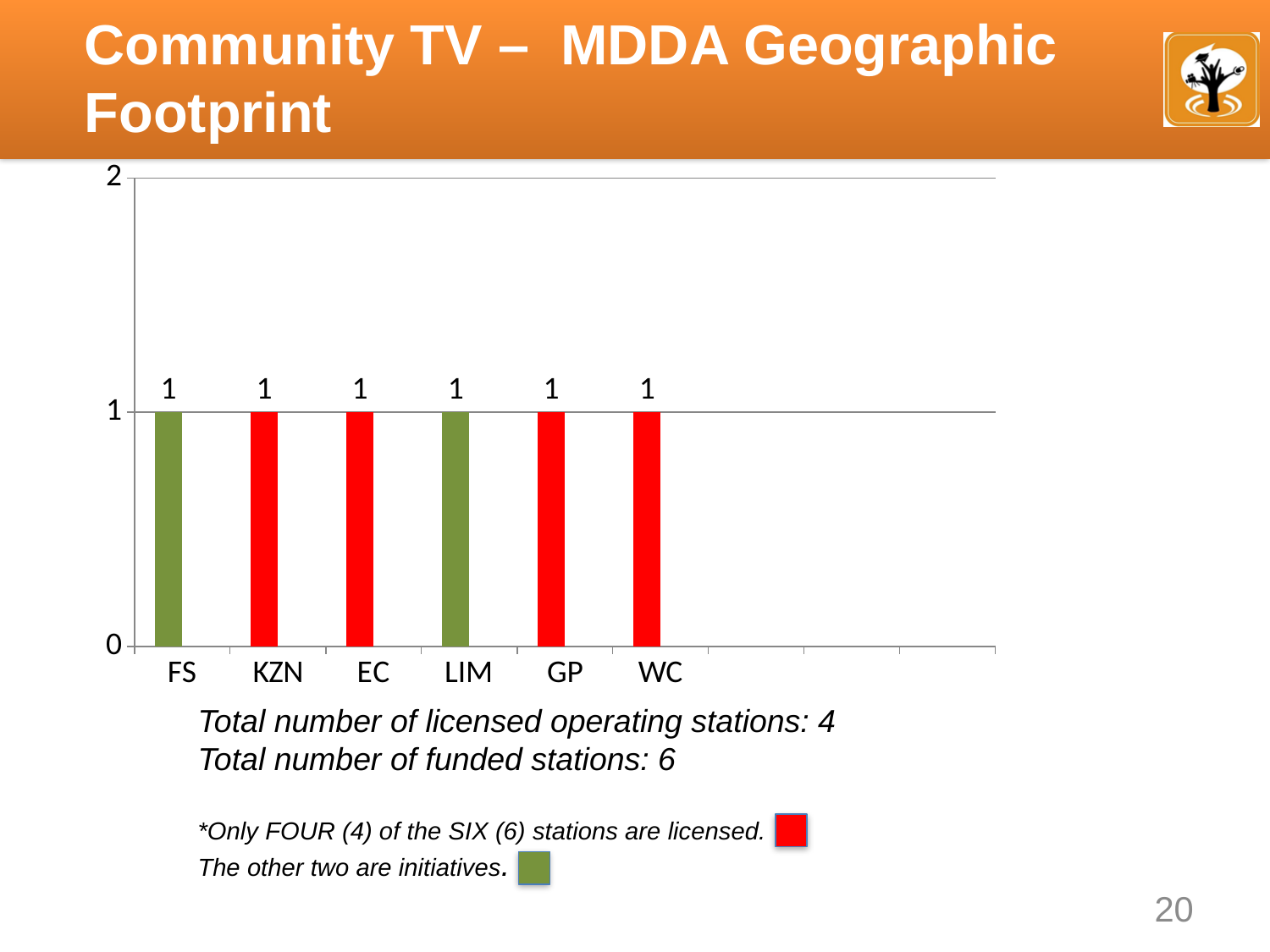
What is the value for KZN? 1 Is the value for GP greater or less than 2? less What is the value for FS? 1 How many categories are shown on the x axis of the chart? 6 What is the highest value shown on the y axis? 2 What is the difference between the values for EC and GP? 0 What is the value for LIM? 1 Do the values rise, fall, or stay flat from FS to WC? stay flat What kind of chart is shown on the slide? bar chart What is the value for WC? 1 How many bars in the chart are green? 2